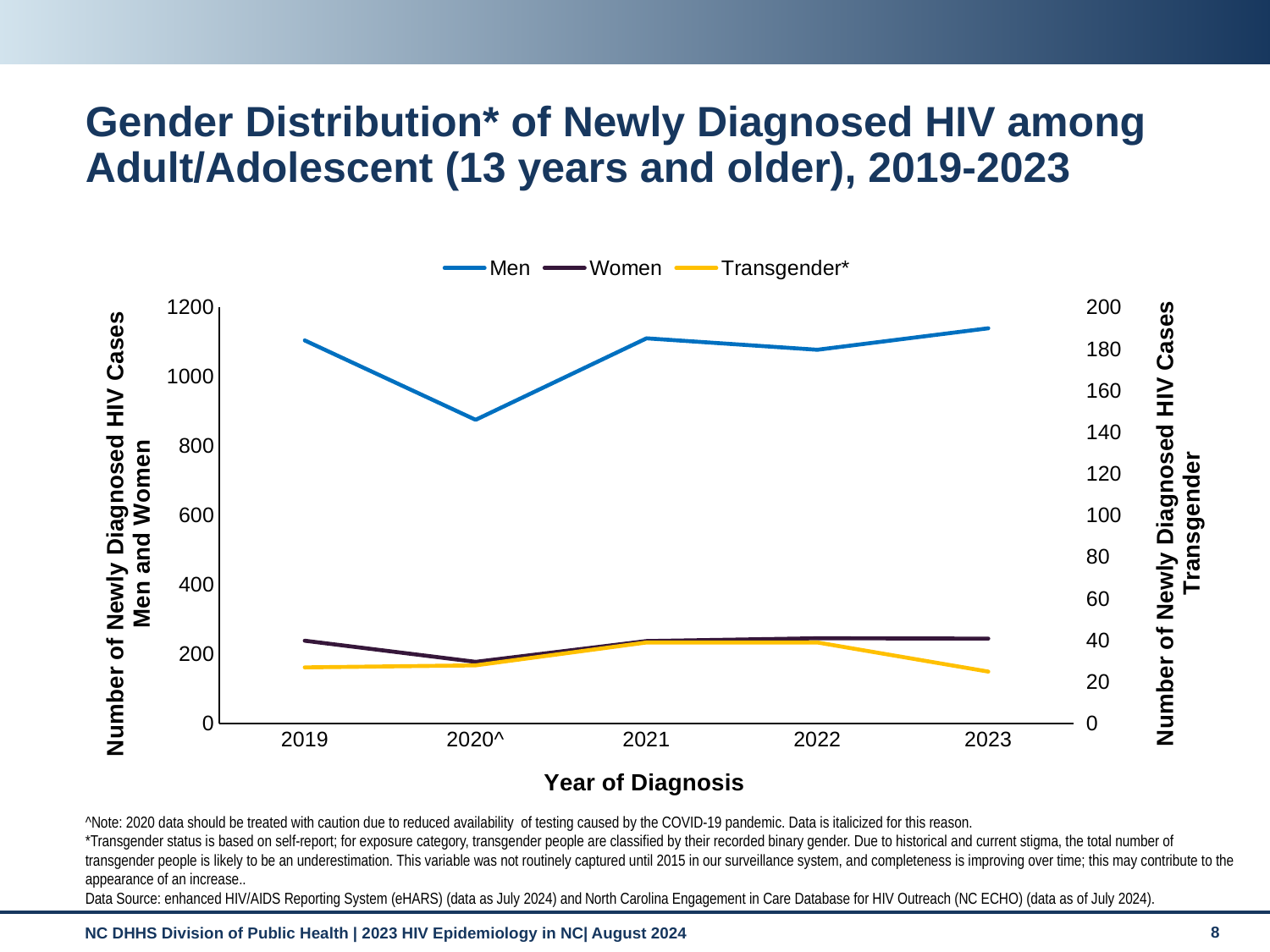
In which year is the value for Women lowest? 2020^ What kind of chart is shown on the slide? line chart How many series does the legend list? 3 Is the value for Women in 2020^ greater or less than 200? less What is the title of the x axis? Year of Diagnosis Is the value for Men in 2019 greater or less than 1000? greater Which series are listed in the legend? Men, Women, Transgender* How many years of diagnosis are plotted along the x axis? 5 Does the Men line rise or fall from 2019 to 2020^? fall Is the value for Men in 2020^ greater or less than 1000? less Which is larger, the value for Men in 2019 or in 2020^? 2019 In which year is the value for Men lowest? 2020^